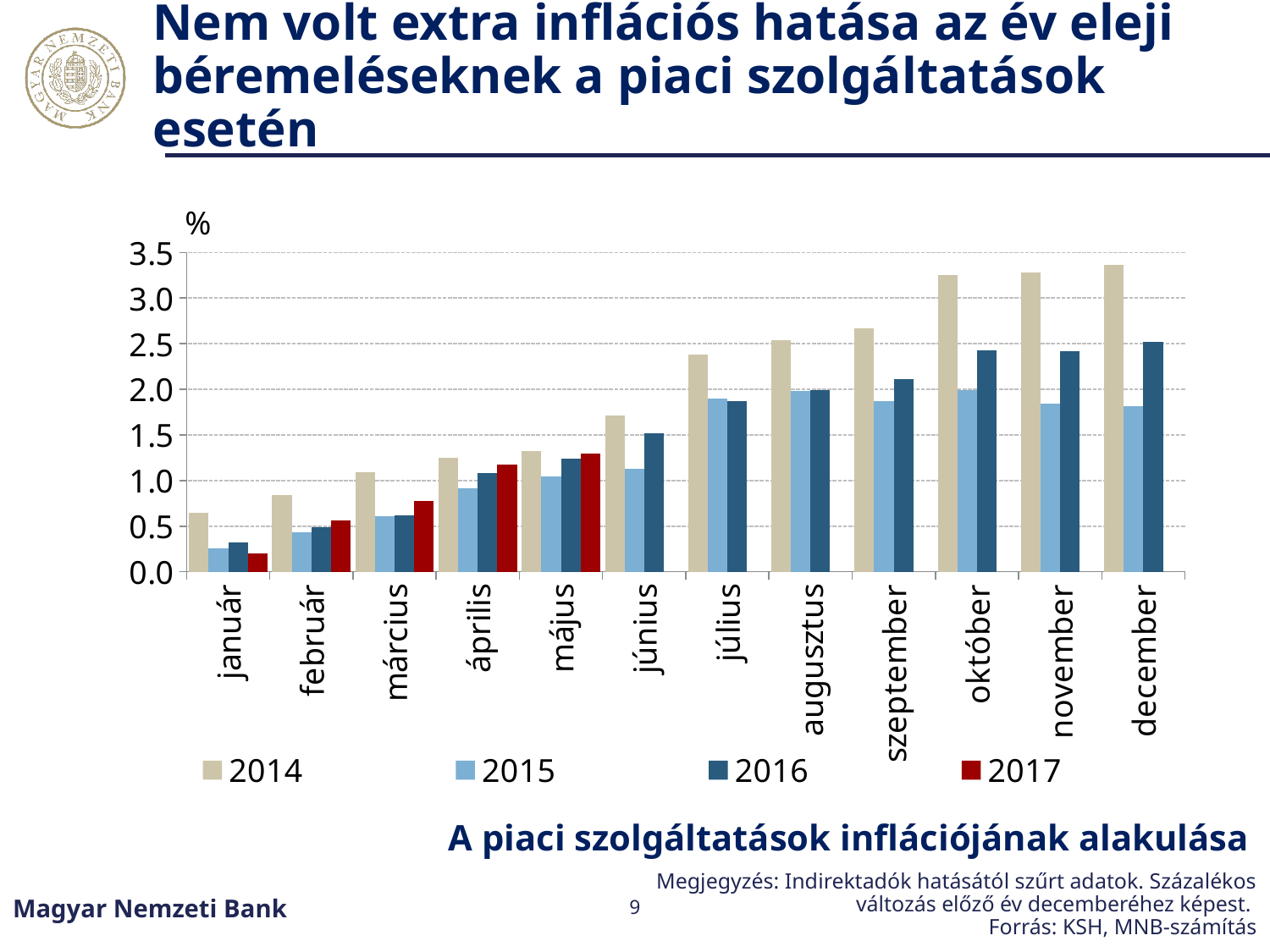
How many months are shown on the x axis? 12 Is the 2016 value for október greater or less than 2.0? greater How many months have a bar for the 2017 series? 5 What kind of chart is shown on the slide? bar chart Do the 2014 values generally rise or fall from január to december? rise Is the 2017 value for május greater or less than 1.0? greater In május, which series has the larger value, 2014 or 2015? 2014 Is the 2014 value for december greater or less than 3.0? greater Which month has the lowest 2014 value? január How many series does the legend list? 4 Which month has the lowest 2017 value? január